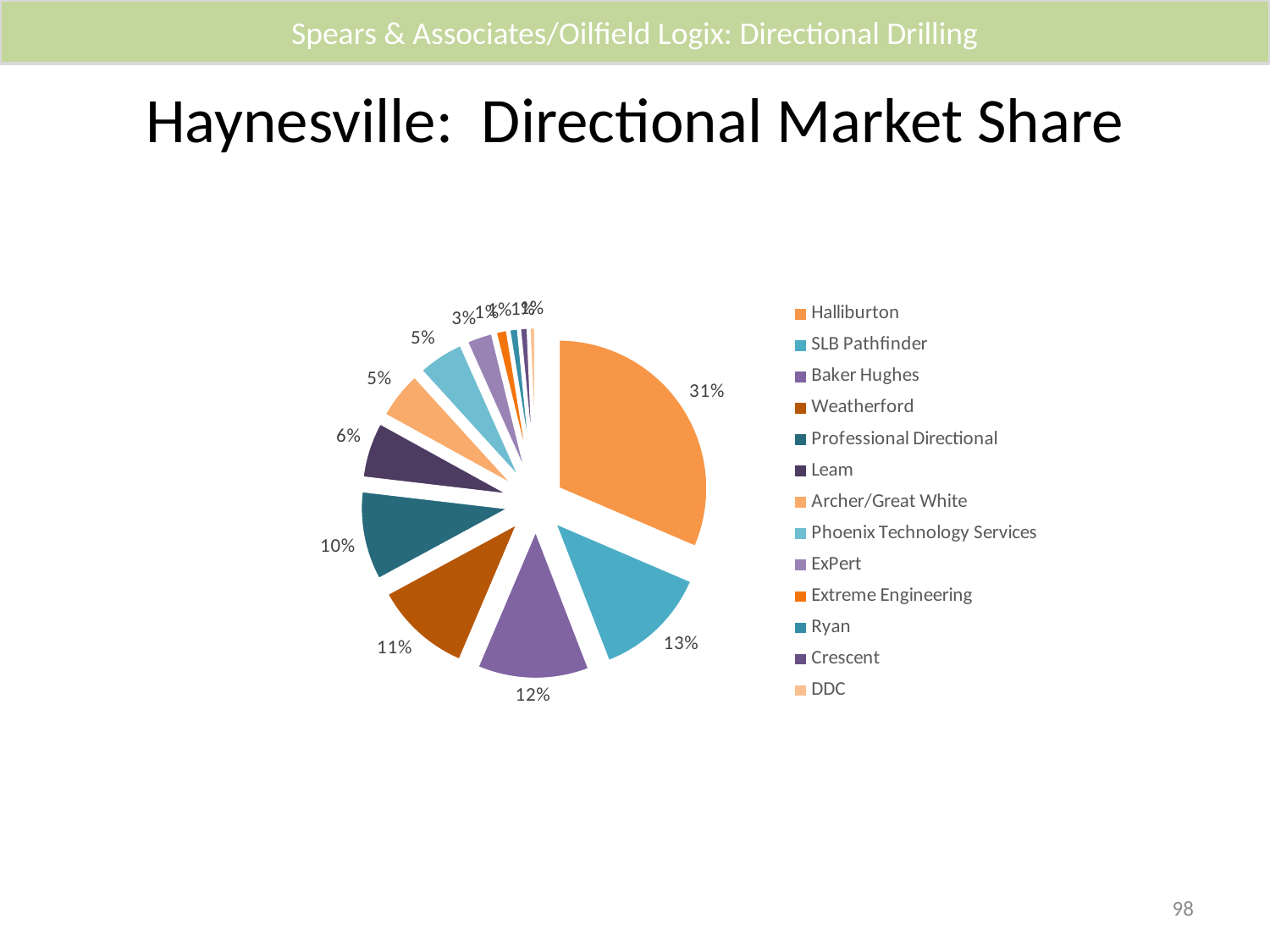
What is the market share shown for Weatherford? 11% How many companies are listed in the chart's legend? 13 Which has the larger market share, Weatherford or Professional Directional? Weatherford What type of chart is shown on the slide? Pie chart What is the market share shown for Leam? 6% What is the market share shown for SLB Pathfinder? 13% How many percentage points larger is Halliburton's share than SLB Pathfinder's share? 18 percentage points Which company has the largest share of the Haynesville directional market? Halliburton What share of the Haynesville directional market does Halliburton hold? 31% What is the title of the chart on the slide? Haynesville: Directional Market Share What is the market share shown for Professional Directional? 10% What is the market share shown for Baker Hughes? 12%